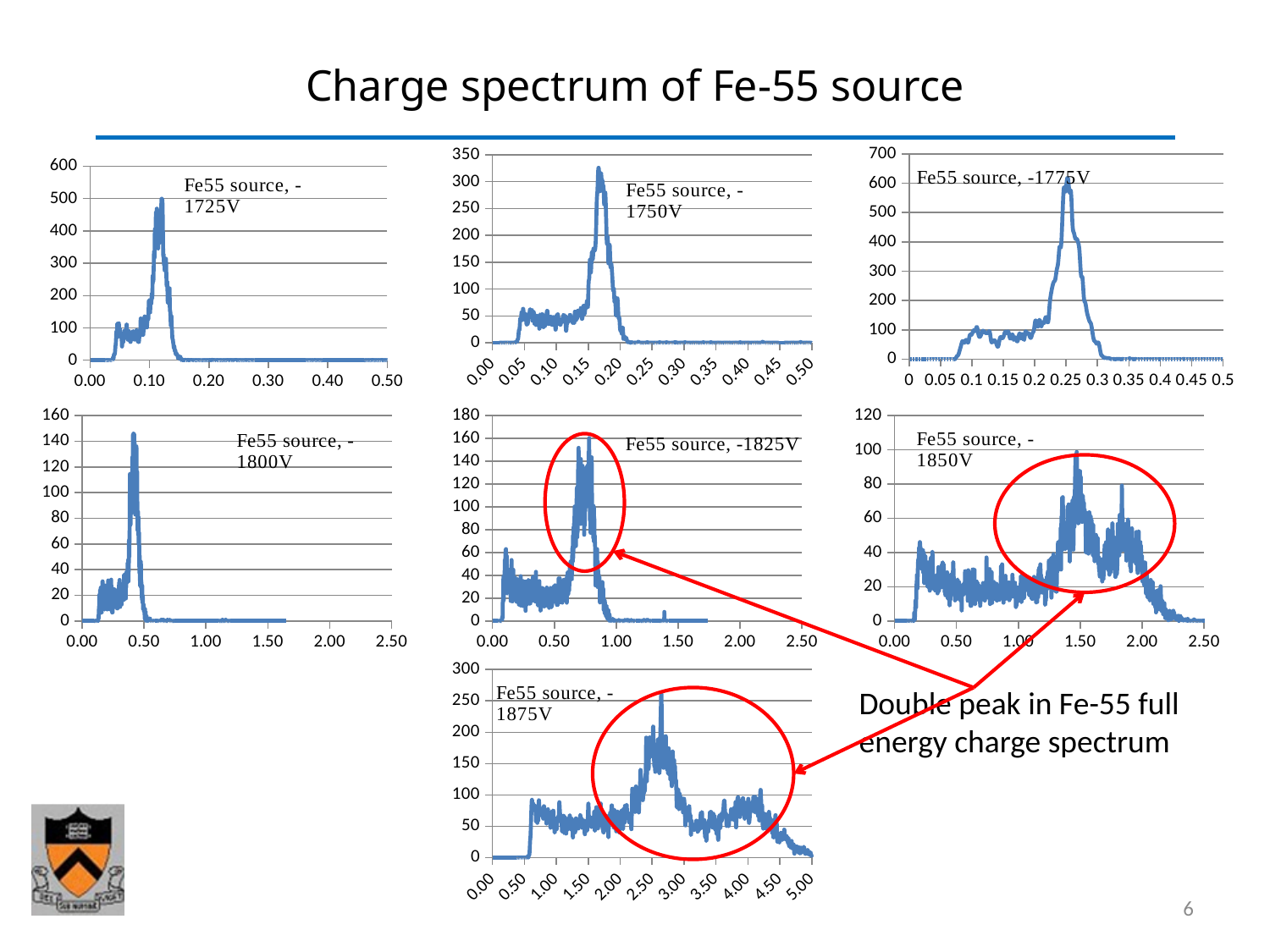
In the 'Fe55 source, -1850V' chart, is the highest value greater or less than 60? greater What kind of chart is the 'Fe55 source, -1725V' chart? line chart What does the red annotation text at the lower right of the slide say? Double peak in Fe-55 full energy charge spectrum How many charts are shown on the slide? 7 In the 'Fe55 source, -1800V' chart, do the values rise or fall between x = 0.50 and x = 1.00? fall In the 'Fe55 source, -1775V' chart, is the peak value greater or less than 500? greater How many data series are plotted in the 'Fe55 source, -1825V' chart? 1 In the 'Fe55 source, -1725V' chart, is the peak value greater or less than 400? greater Which chart has the higher peak value: 'Fe55 source, -1725V' or 'Fe55 source, -1800V'? Fe55 source, -1725V